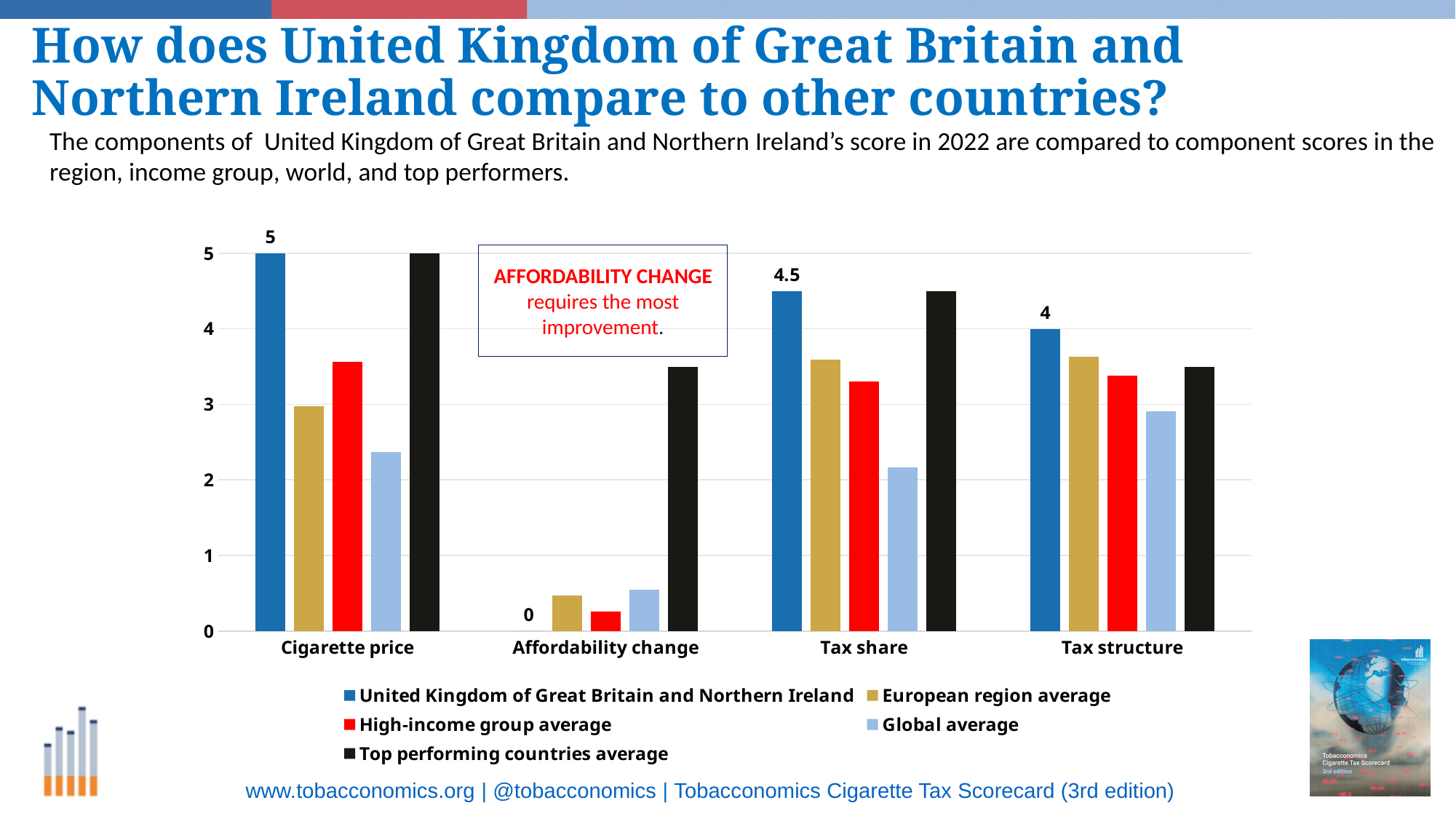
Is the Global average value for Tax share greater or less than 3? less What is the difference between the United Kingdom's Cigarette price score and its Tax structure score? 1 How many categories are shown on the x axis of the chart? 4 What is the value for United Kingdom of Great Britain and Northern Ireland in the Affordability change category? 0 What is the value for United Kingdom of Great Britain and Northern Ireland in the Cigarette price category? 5 What is the value for United Kingdom of Great Britain and Northern Ireland in the Tax share category? 4.5 How many series does the legend list? 5 In which category does United Kingdom of Great Britain and Northern Ireland have its lowest score? Affordability change What is the value for United Kingdom of Great Britain and Northern Ireland in the Tax structure category? 4 In which category does United Kingdom of Great Britain and Northern Ireland have its highest score? Cigarette price For the United Kingdom, which is larger: the Tax share score or the Tax structure score? Tax share Is the Top performing countries average value for Affordability change greater or less than 3? greater